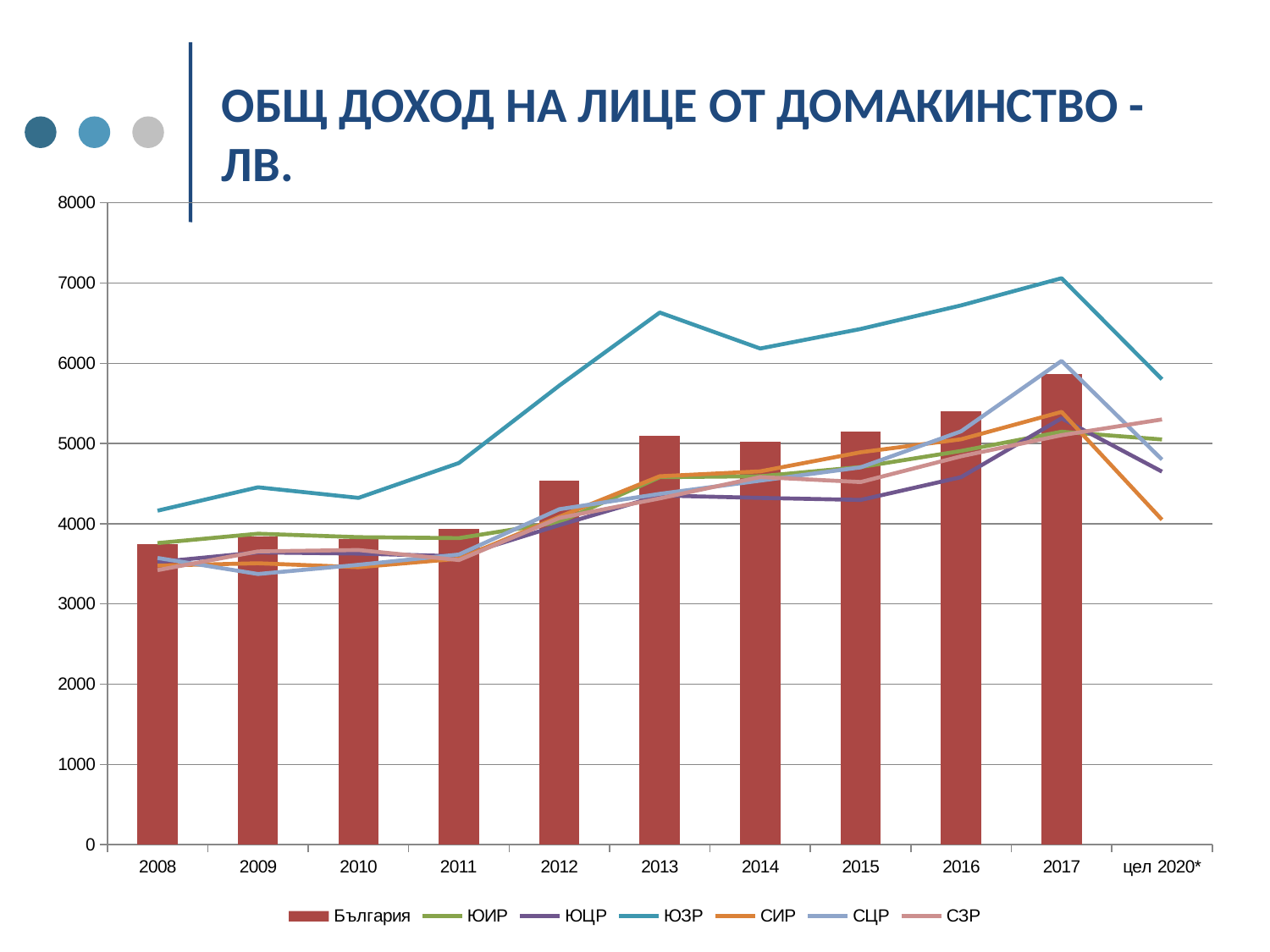
How many categories are shown on the x axis? 11 In which year is the България bar lowest? 2008 Is the value for България in 2008 greater or less than 4000? less Do the България bars rise or fall from 2008 to 2017? rise What kind of chart is this? Combined bar and line chart Which series has the lowest value at цел 2020*? СИР In which year is the България bar highest? 2017 Is the value for България in 2017 greater or less than 5000? greater How many series does the legend list? 7 Which series has the highest value in 2013? ЮЗР Which series is plotted as bars? България Is the value for СИР at цел 2020* greater or less than 5000? less